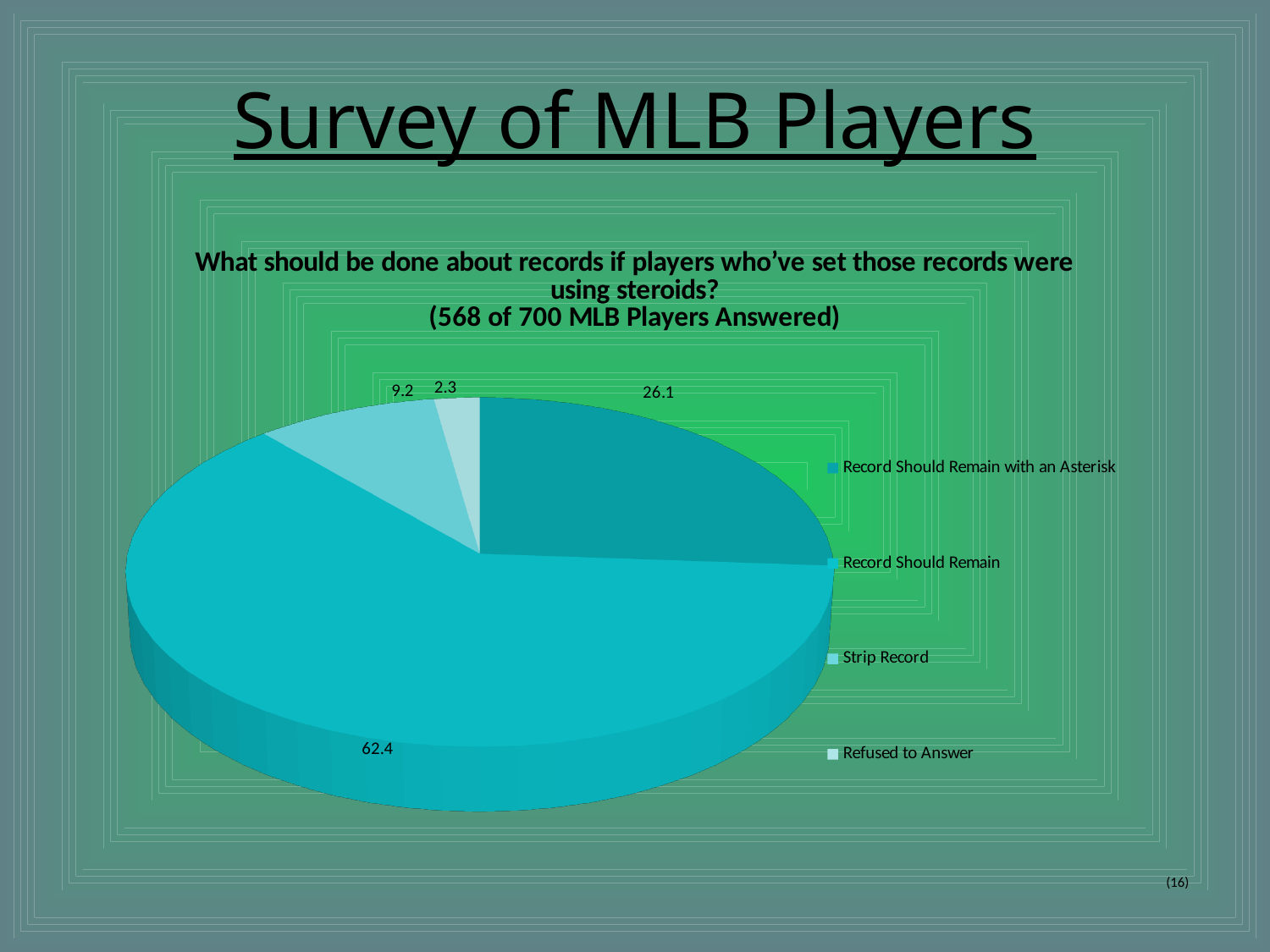
What value is shown for the 'Record Should Remain with an Asterisk' slice? 26.1 Which response has the smallest share of the pie? Refused to Answer Which legend entry is listed first? Record Should Remain with an Asterisk What value is shown for the 'Record Should Remain' slice? 62.4 What is the difference between the values for 'Record Should Remain' and 'Record Should Remain with an Asterisk'? 36.3 Which response has the largest share of the pie? Record Should Remain Which is larger, the value for 'Strip Record' or the value for 'Refused to Answer'? Strip Record How many slices does the pie chart have? 4 How many MLB players answered the survey question, according to the chart title? 568 of 700 What kind of chart is shown on the slide? Pie chart What value is shown for the 'Strip Record' slice? 9.2 What value is shown for the 'Refused to Answer' slice? 2.3